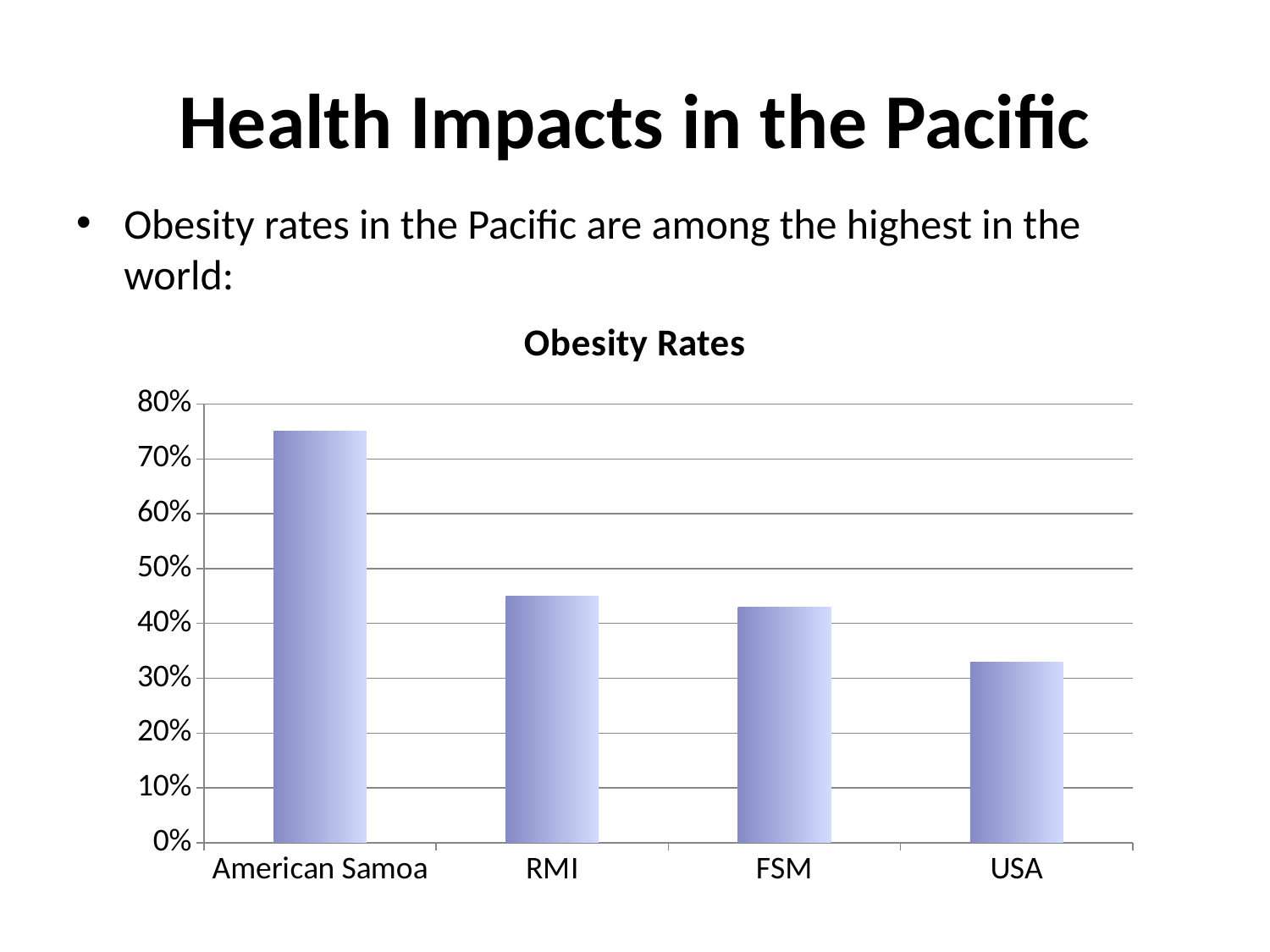
Which category has the highest obesity rate in the chart? American Samoa What type of chart is shown on the slide? bar chart Is the value for American Samoa greater or less than 70%? greater Which has a higher obesity rate, RMI or USA? RMI Is the value for RMI greater or less than 50%? less Is the value for USA greater or less than 40%? less How many categories are shown on the x axis of the chart? 4 Which category has the lowest obesity rate in the chart? USA Do the values rise or fall moving from left to right along the x axis? fall What is the title of the chart? Obesity Rates Which has a higher obesity rate, American Samoa or USA? American Samoa